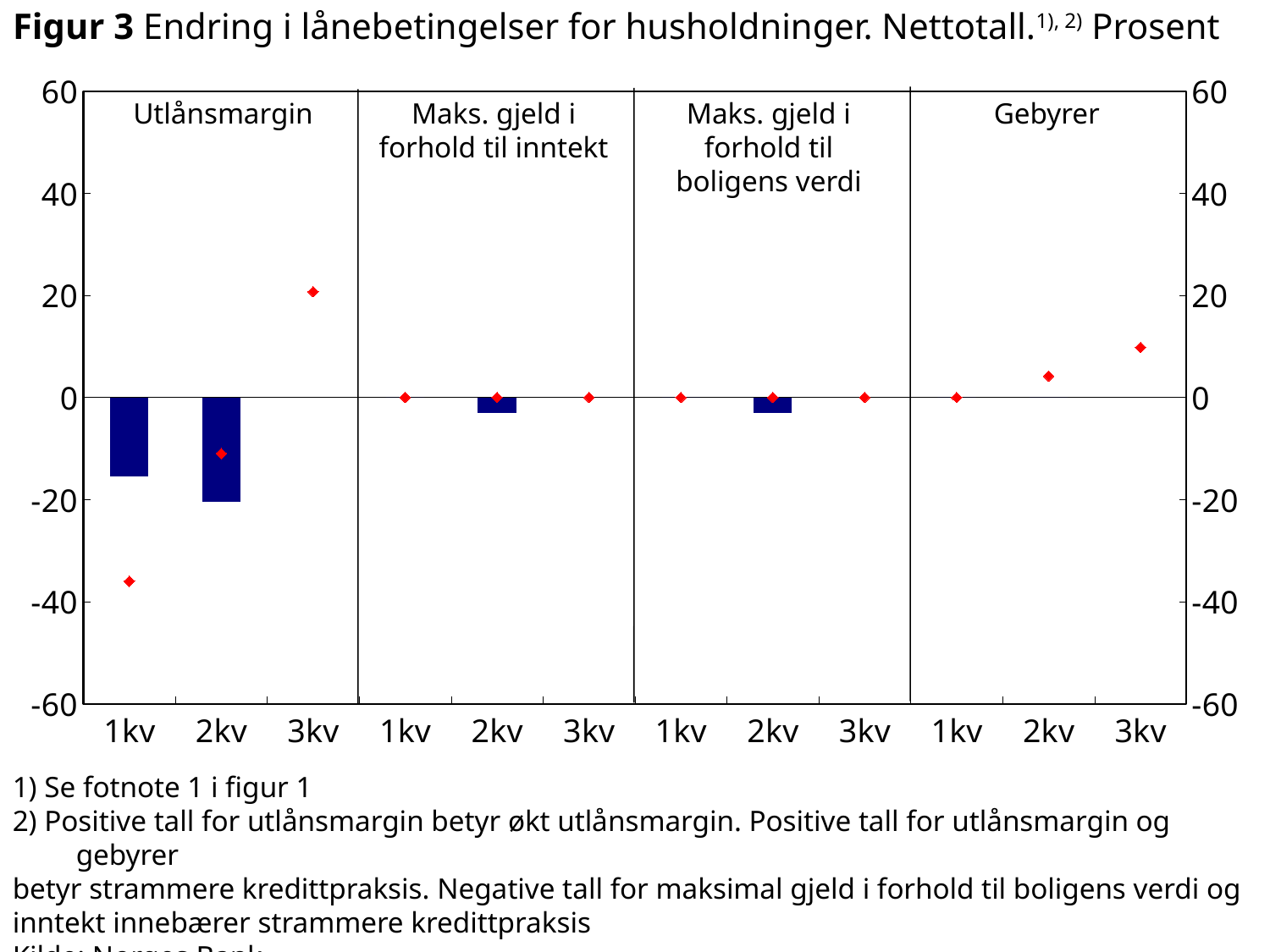
In the Utlånsmargin panel, which quarter has the lowest red marker? 1kv In the Utlånsmargin panel, which quarter has the highest red marker? 3kv Do the red markers in the Gebyrer panel rise or fall from 1kv to 3kv? rise Which panel of the chart has no blue bars at all? Gebyrer How many panels (loan condition categories) does the chart have? 4 Is the red marker for 1kv in the Utlånsmargin panel greater or less than -20? less In the Utlånsmargin panel, which bar is lower (more negative): 1kv or 2kv? 2kv Is the bar for 2kv in the Utlånsmargin panel greater or less than -40? greater Is the red marker for 3kv in the Gebyrer panel greater or less than 20? less What kind of chart is shown in Figur 3? combination chart (blue bars with red diamond markers) How many quarters are shown in each panel of the chart? 3